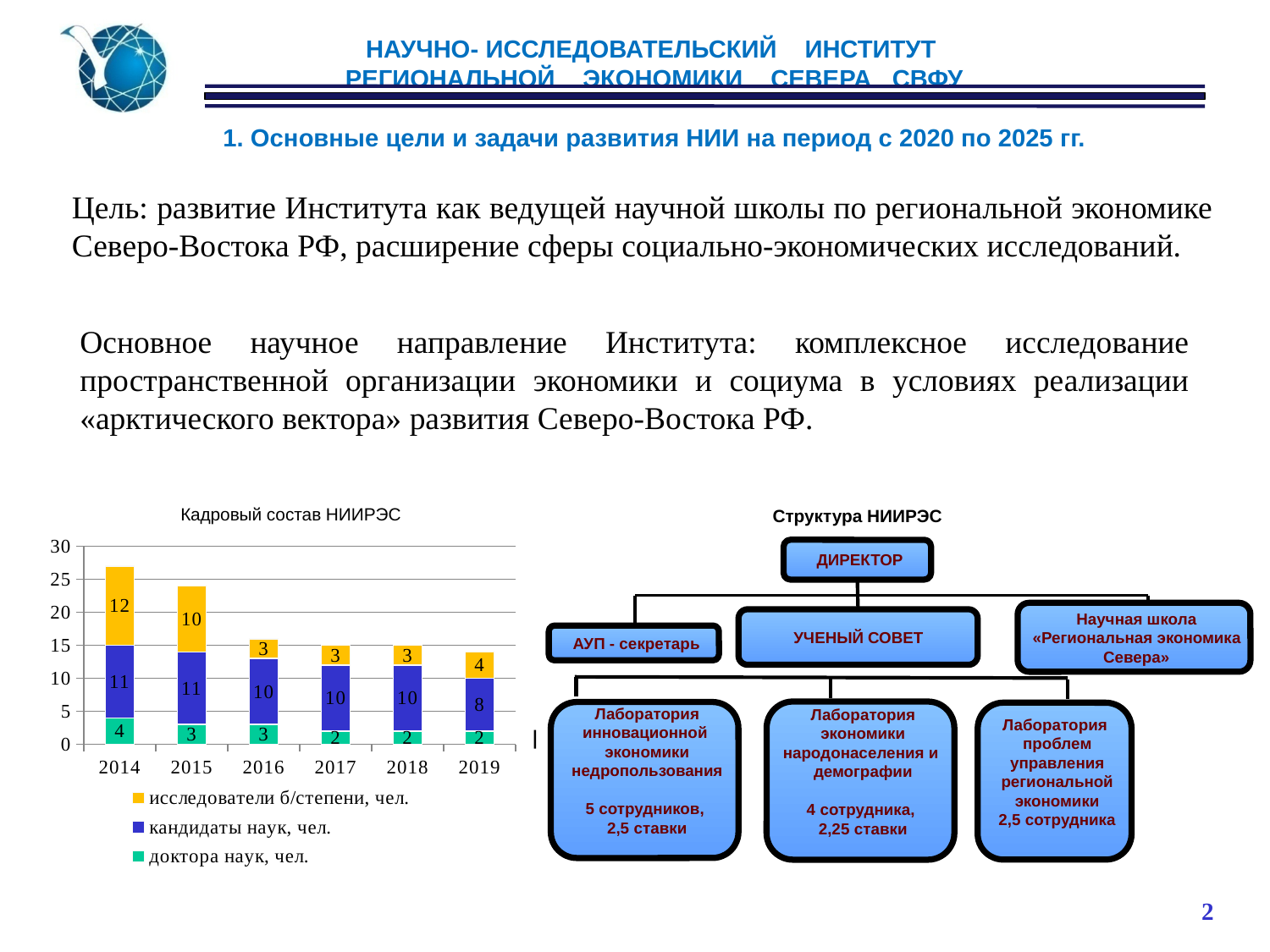
How many series does the legend of the "Кадровый состав НИИРЭС" chart list? 3 In the "Кадровый состав НИИРЭС" chart, what is the difference between the "исследователи б/степени, чел." values for 2014 and 2015? 2 In the "Кадровый состав НИИРЭС" chart, what is the value for "исследователи б/степени, чел." in 2014? 12 How many years are shown on the x axis of the "Кадровый состав НИИРЭС" chart? 6 In the "Кадровый состав НИИРЭС" chart, do the total bar heights rise or fall from 2014 to 2019? fall In the "Кадровый состав НИИРЭС" chart, what is the value for "доктора наук, чел." in 2015? 3 In the "Кадровый состав НИИРЭС" chart, is the "кандидаты наук, чел." value larger in 2016 or in 2019? 2016 In the "Кадровый состав НИИРЭС" chart, which year has the lowest value for "кандидаты наук, чел."? 2019 What type of chart is "Кадровый состав НИИРЭС"? stacked bar chart In the "Кадровый состав НИИРЭС" chart, what is the value for "кандидаты наук, чел." in 2019? 8 In the "Кадровый состав НИИРЭС" chart, what is the total of the stacked bar for 2014? 27 In the "Кадровый состав НИИРЭС" chart, which year has the highest value for "доктора наук, чел."? 2014